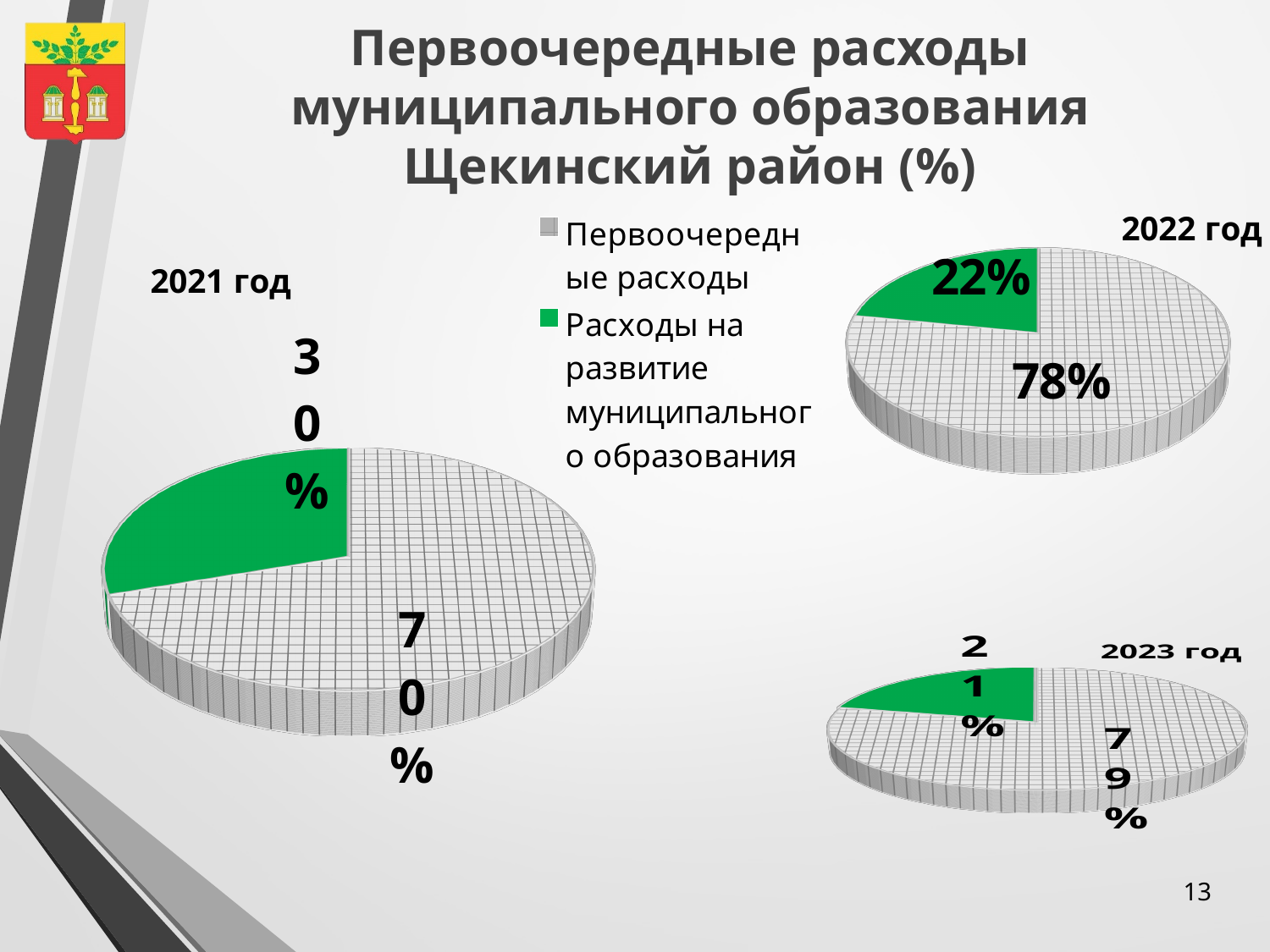
In the 2021 год chart, what share is shown for Первоочередные расходы? 70% How many entries does the legend list? 2 In the 2023 год chart, what share is shown for Первоочередные расходы? 79% Which is larger: the share of Расходы на развитие муниципального образования in the 2021 год chart or in the 2022 год chart? 2021 год In the 2021 год chart, what share is shown for Расходы на развитие муниципального образования? 30% In the 2022 год chart, what is the difference between the shares of Первоочередные расходы and Расходы на развитие муниципального образования? 56% In the 2023 год chart, which category has the smallest slice? Расходы на развитие муниципального образования What type of chart is used for the 2022 год data? Pie chart In the 2021 год chart, which category has the largest slice? Первоочередные расходы